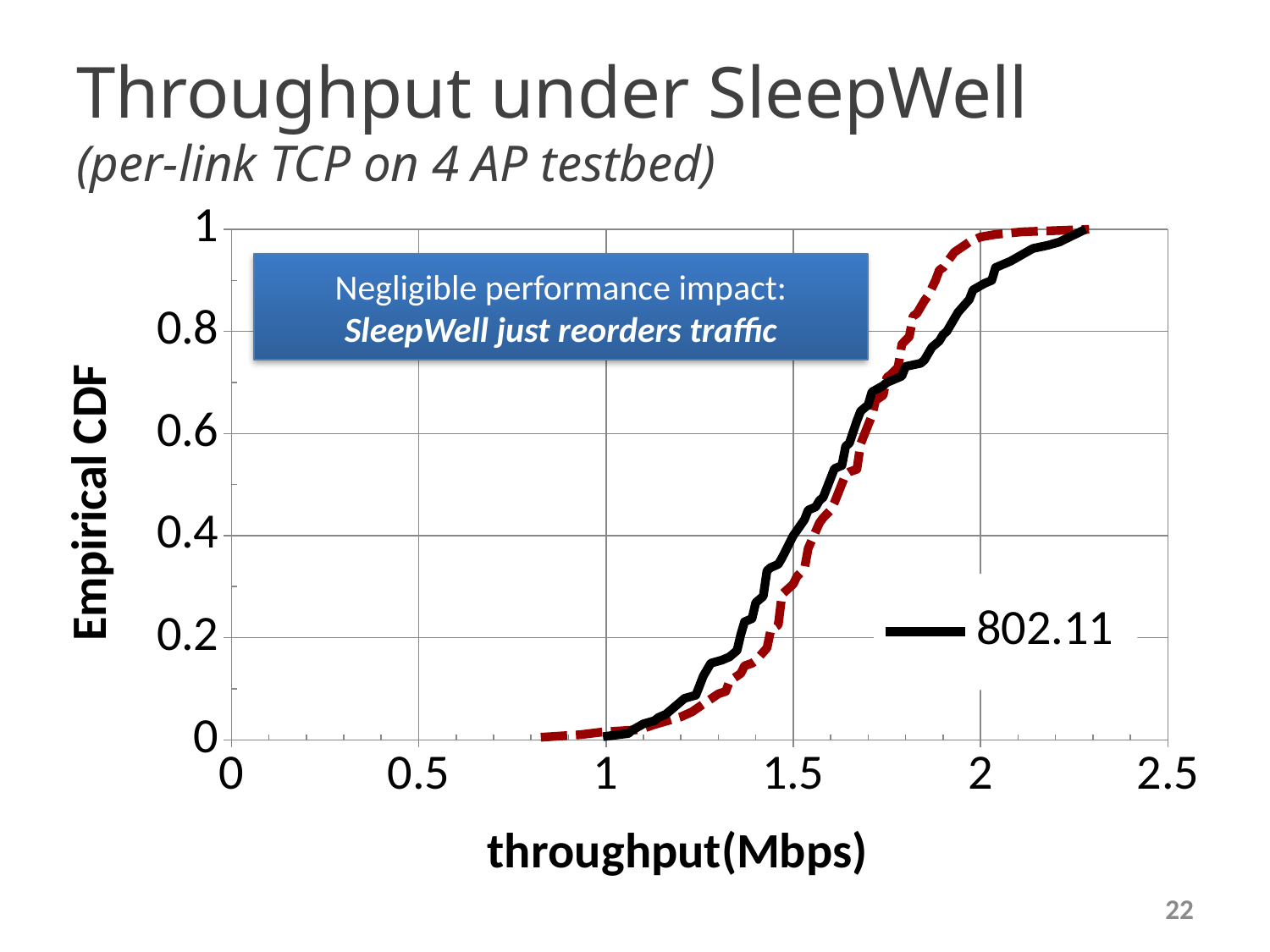
Is the Empirical CDF value of the 802.11 line at a throughput of 1 Mbps greater or less than 0.2? less What is the label of the y axis? Empirical CDF How many lines are plotted on the chart? 2 What kind of chart is shown on the slide? line chart Is the Empirical CDF value of the red dashed line at a throughput of 2 Mbps greater or less than 0.8? greater Do the values of the 802.11 line rise or fall as throughput increases along the x axis? rise Is the Empirical CDF value of the 802.11 line at a throughput of 2 Mbps greater or less than 0.8? greater At a throughput of 2 Mbps, which line has the higher Empirical CDF value, the black 802.11 line or the red dashed line? the red dashed line How many series does the legend list? 1 At a throughput of 1.5 Mbps, which line has the higher Empirical CDF value, the black 802.11 line or the red dashed line? the black 802.11 line What is the name of the series listed in the legend? 802.11